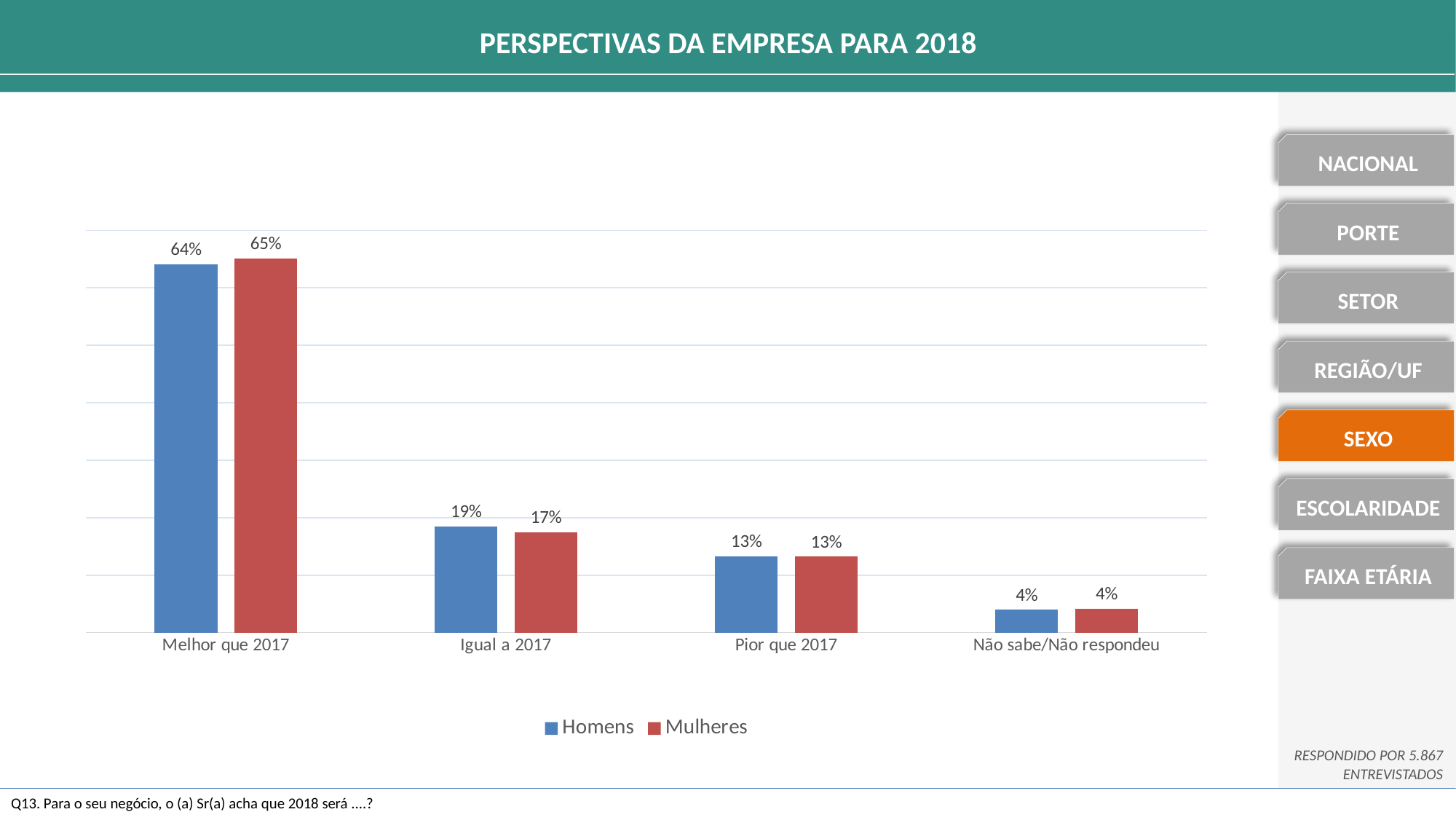
What is the value for Mulheres in the 'Não sabe/Não respondeu' category? 4% How many categories are shown on the x axis? 4 Which category has the highest value for Mulheres? Melhor que 2017 What is the difference between the Homens and Mulheres values in the 'Igual a 2017' category? 2% What is the value for Mulheres in the 'Igual a 2017' category? 17% How many series does the legend list? 2 What is the value for Homens in the 'Melhor que 2017' category? 64% Which category has the lowest value for Homens? Não sabe/Não respondeu Which series is shown in red in the legend? Mulheres Which is larger in the 'Igual a 2017' category, Homens or Mulheres? Homens What is the difference between the Homens values for 'Melhor que 2017' and 'Pior que 2017'? 51% What kind of chart is shown on the slide? Bar chart